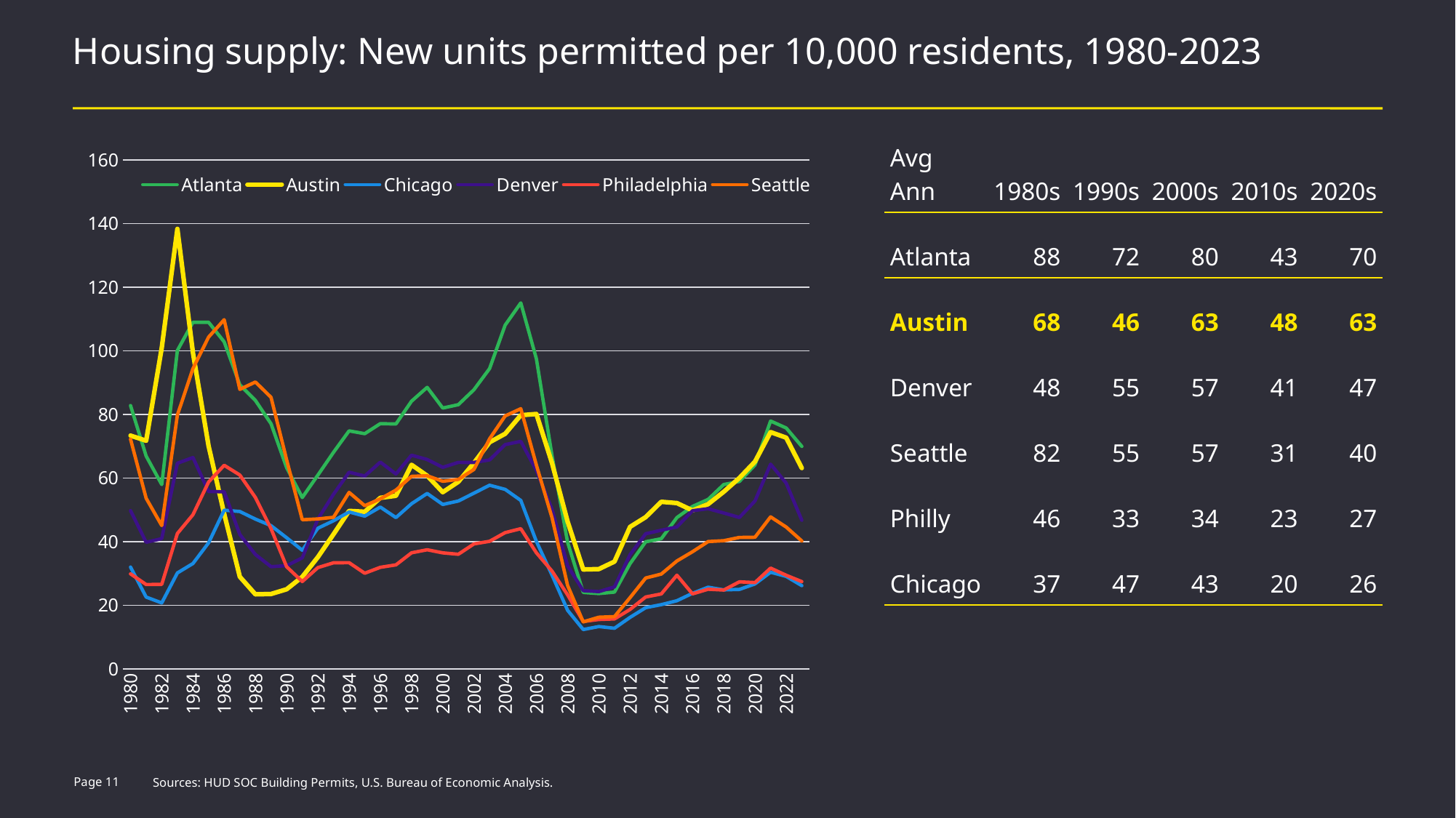
Which cities are listed in the chart's legend? Atlanta, Austin, Chicago, Denver, Philadelphia, Seattle Is the value for Austin in 1983 greater or less than 120? greater What is the title of the slide's chart? Housing supply: New units permitted per 10,000 residents, 1980-2023 What kind of chart is shown on the slide? line chart Is the value for Philadelphia in 2023 greater or less than 40? less Does the Atlanta line rise or fall between 2005 and 2009? fall Which series reaches the highest peak on the chart? Austin In 2005, which is larger: the value for Atlanta or the value for Chicago? Atlanta Is the value for Seattle in 1986 greater or less than 100? greater How many series does the chart's legend list? 6